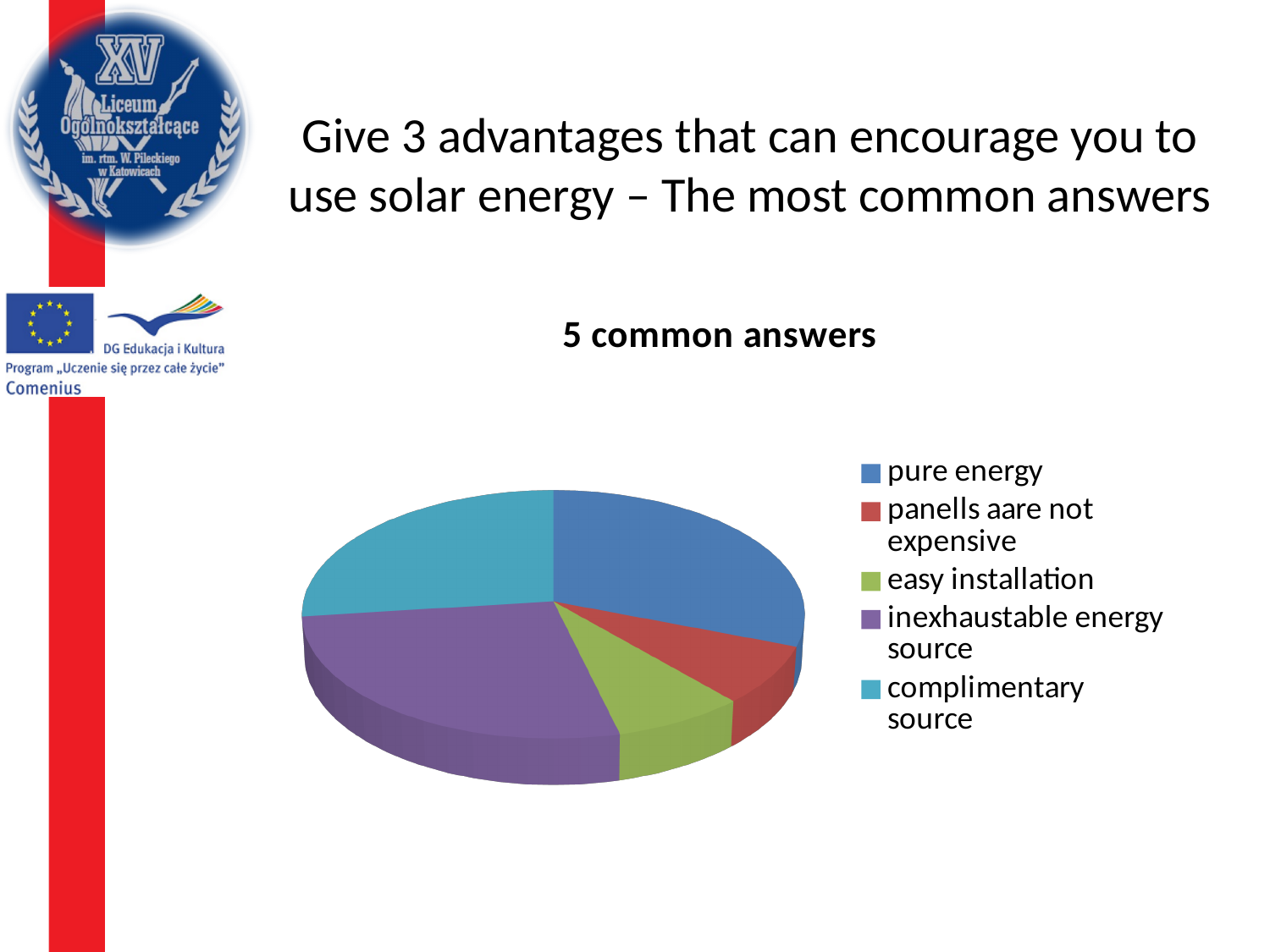
Which slice is larger: "complimentary source" or "easy installation"? complimentary source How many entries does the legend list? 5 Which slice is larger: "pure energy" or "panells aare not expensive"? pure energy How many slices does the pie chart have? 5 What kind of chart is shown on the slide? pie chart Which slice is larger: "inexhaustable energy source" or "easy installation"? inexhaustable energy source Which colour represents "pure energy" in the pie chart? blue What is the title of the chart? 5 common answers